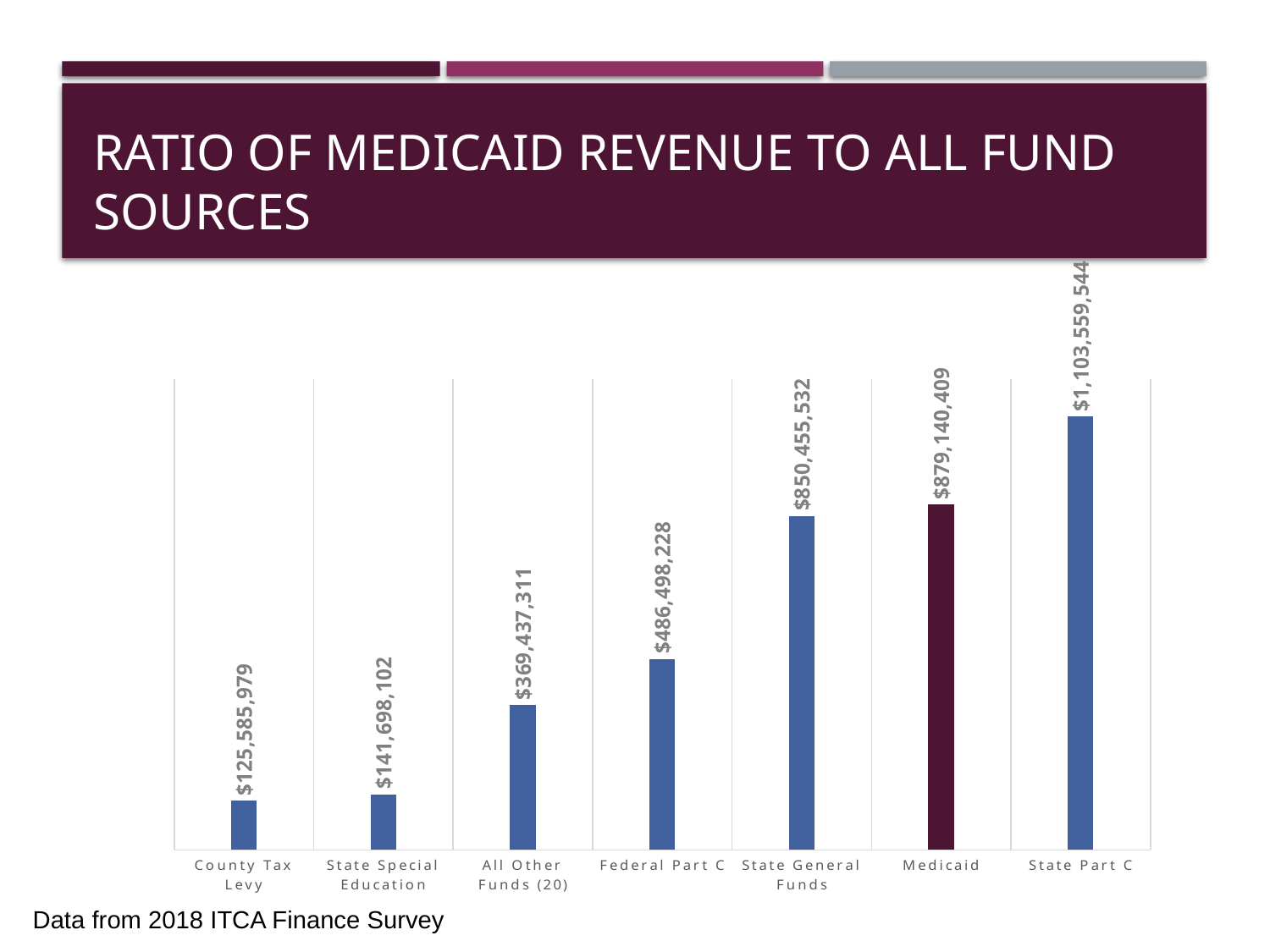
What is the value for County Tax Levy? $125,585,979 What is the value for Medicaid? $879,140,409 What is the value for All Other Funds (20)? $369,437,311 What is the value for Federal Part C? $486,498,228 What kind of chart is shown on the slide? Bar chart What is the difference between Medicaid and State General Funds? $28,684,877 How many categories are shown in the chart? 7 Which category has the highest value? State Part C What is the difference between State Part C and Medicaid? $224,419,135 Which bar is shown in a different colour from the others? Medicaid Which category has the lowest value? County Tax Levy Which is larger, State General Funds or Federal Part C? State General Funds